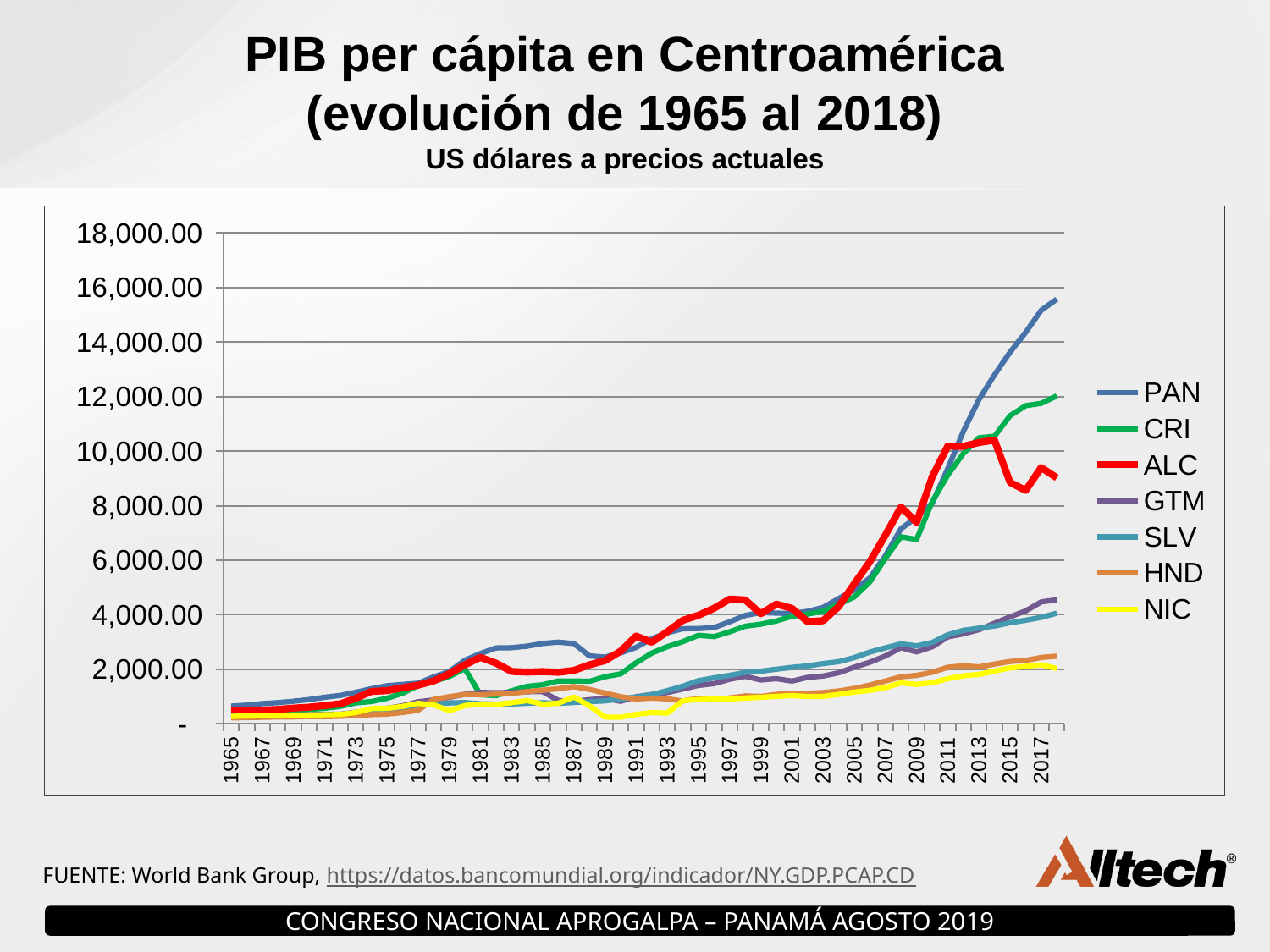
What colour is the ALC line in the chart? Red Which series has the highest value at the end of the period (2018)? PAN What is the title of the slide? PIB per cápita en Centroamérica (evolución de 1965 al 2018) Which series has the lowest value at the end of the period (2018)? NIC Is the value for HND in 2018 greater or less than 2,000.00? greater How many series does the legend list? 7 Is the value for ALC in 2018 greater or less than 10,000.00? less Which series is higher in 2018, PAN or CRI? PAN Which series is higher in 2018, CRI or ALC? CRI Does the PAN series generally rise or fall from 1965 to 2018? Rise Is the value for PAN in 2018 greater or less than 14,000.00? greater What kind of chart is shown on the slide? Line chart